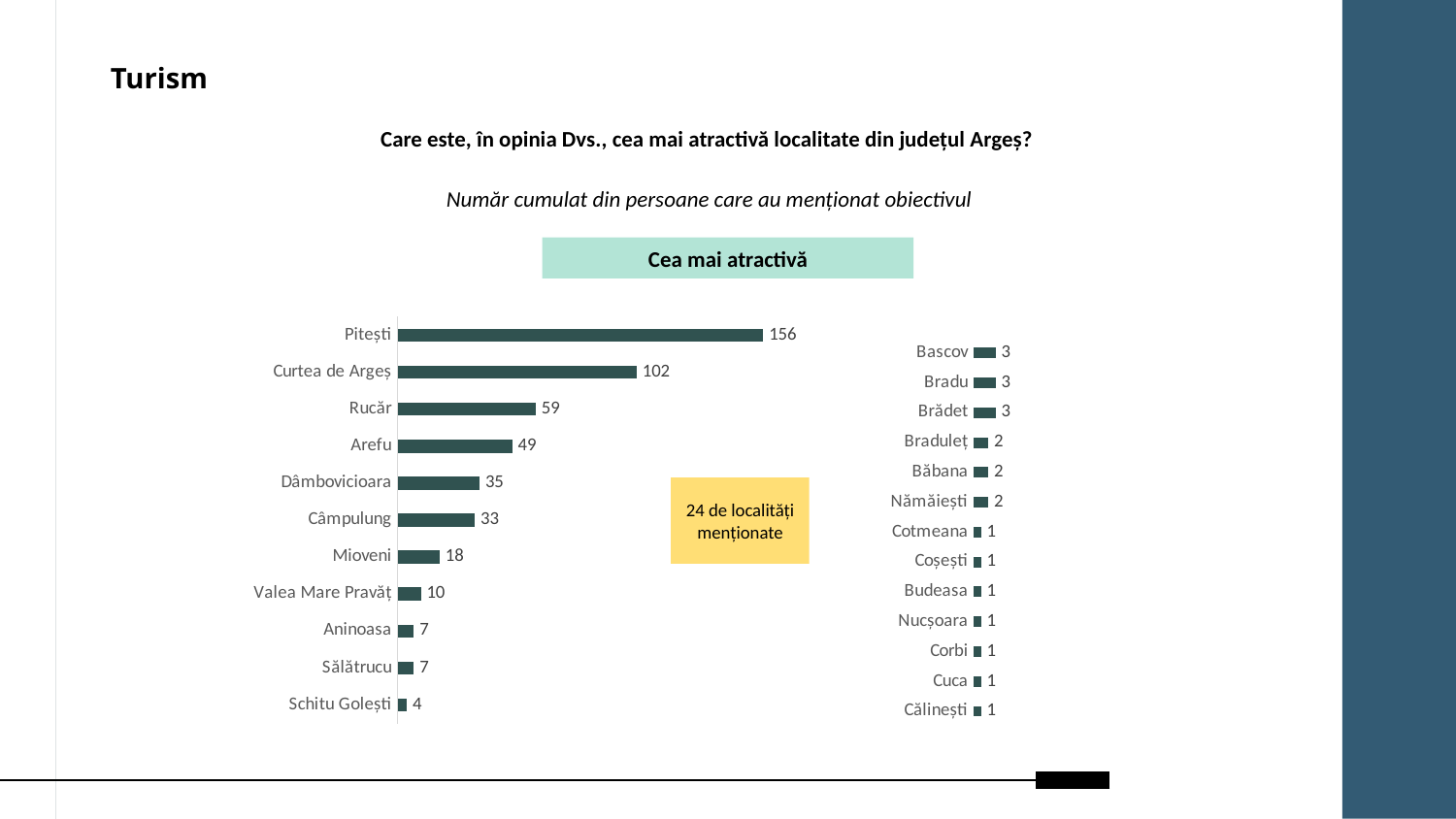
In the right chart, what is the value for Nămăiești? 2 In the right chart, what is the value for Bascov? 3 In the left chart, what is the difference between the values for Pitești and Curtea de Argeș? 54 According to the yellow box on the slide, how many localities were mentioned in total? 24 In the left chart, what is the value for Curtea de Argeș? 102 In the left chart, what is the value for Pitești? 156 In the left chart, which locality has the highest value? Pitești How many localities are shown in the left chart? 11 What kind of chart is the left chart? Bar chart In the left chart, which locality has the lowest value? Schitu Golești How many localities are shown in the right chart? 13 In the left chart, which is larger, the value for Rucăr or the value for Arefu? Rucăr